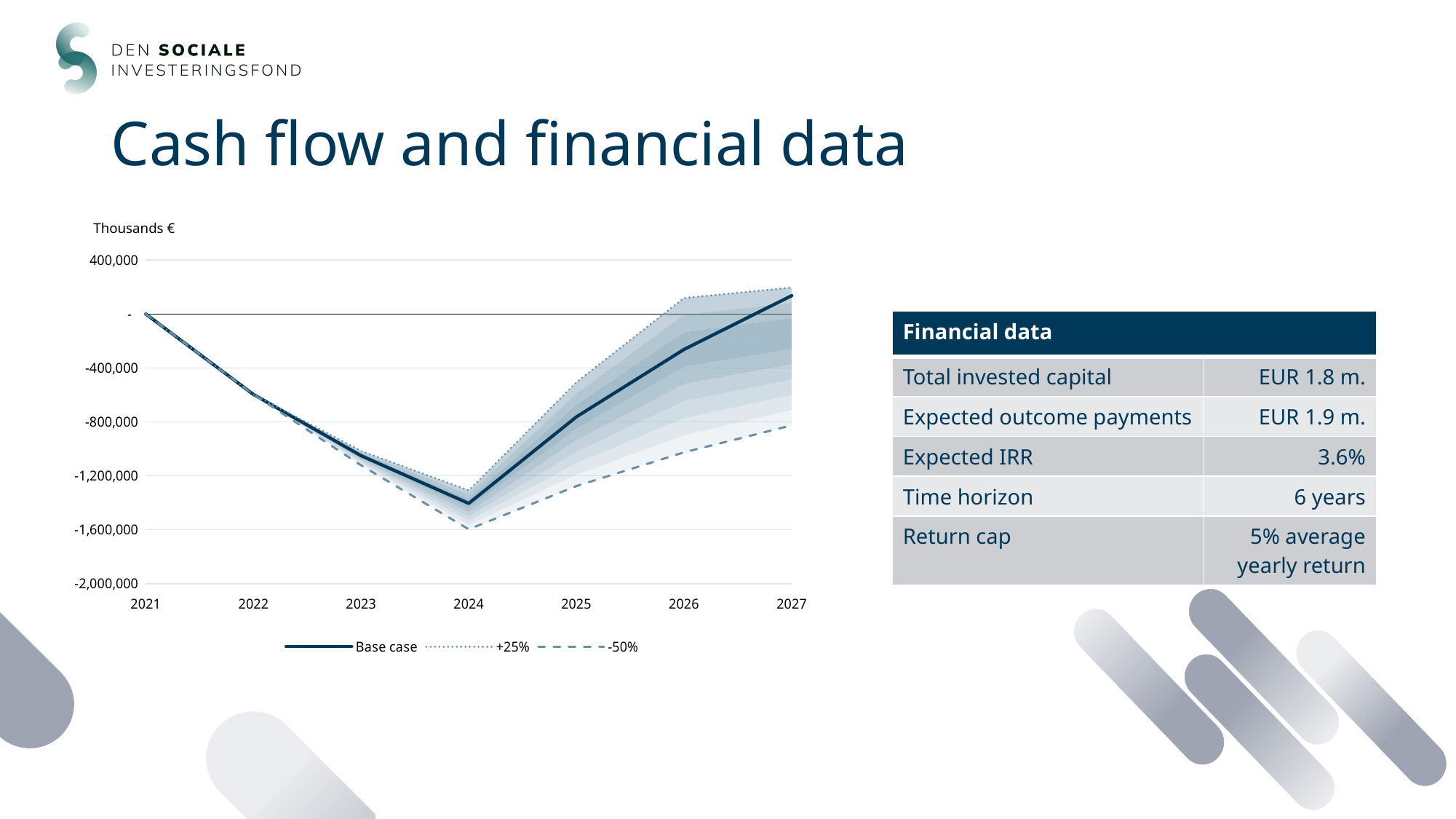
How many years are shown along the x axis of the chart? 7 In 2024, which series has the higher value: Base case or -50%? Base case Does the Base case line rise or fall from 2021 to 2024? fall Is the -50% value in 2027 greater or less than -400,000? less In 2027, which series has the higher value: +25% or -50%? +25% What kind of chart is shown on the slide? line chart Is the Base case value in 2024 greater or less than -1,200,000? less Is the Base case value in 2027 greater or less than 0? greater Does the Base case line rise or fall from 2024 to 2027? rise How many series does the chart legend list? 3 In which year does the Base case line reach its lowest value? 2024 What unit is shown above the y axis of the chart? Thousands €